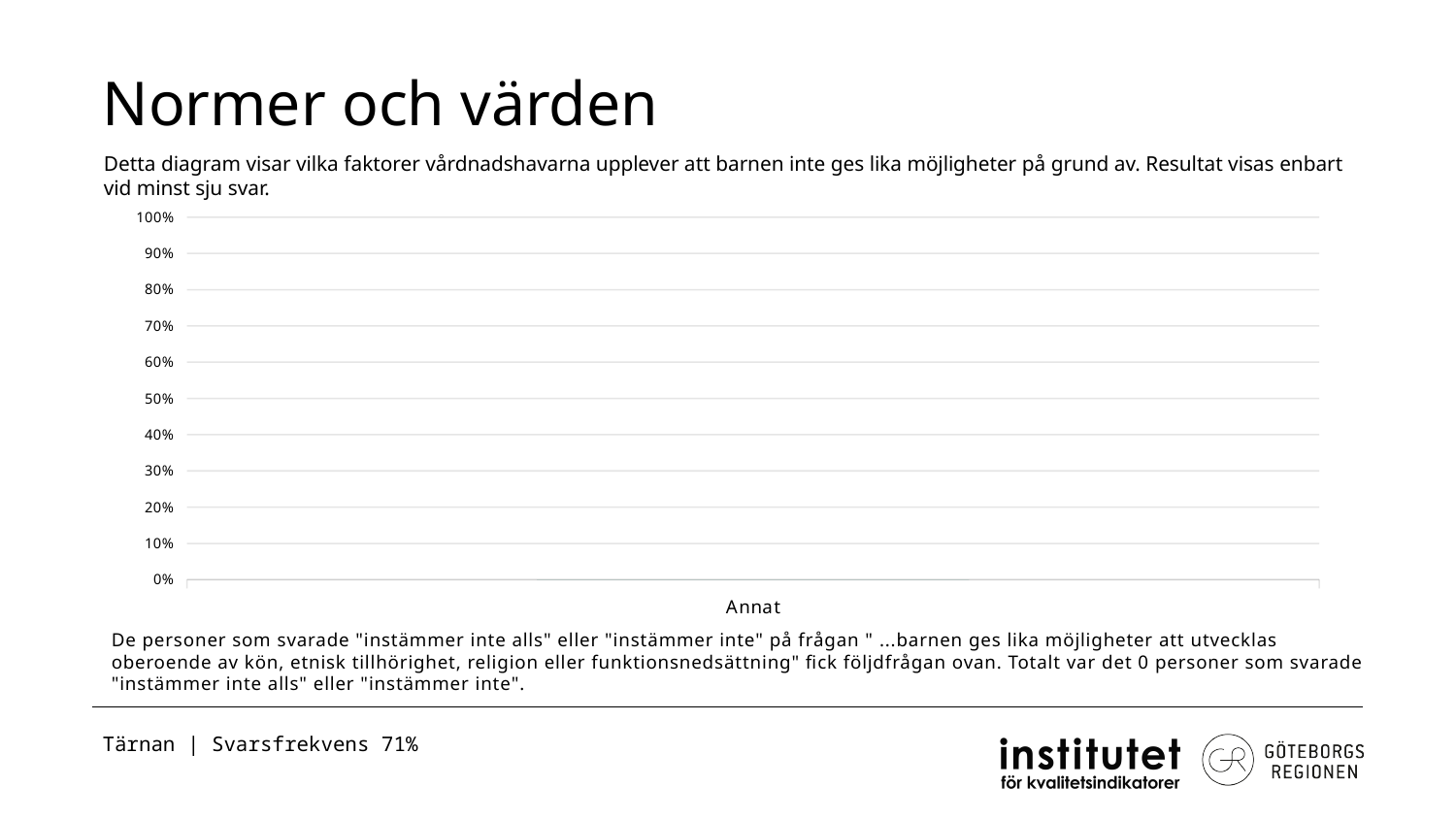
What is the highest value shown on the chart's y axis? 100% How many category labels are shown on the x axis of the chart? 1 What is the only category label shown on the chart's x axis? Annat Are any bars plotted for the category Annat on the chart? No